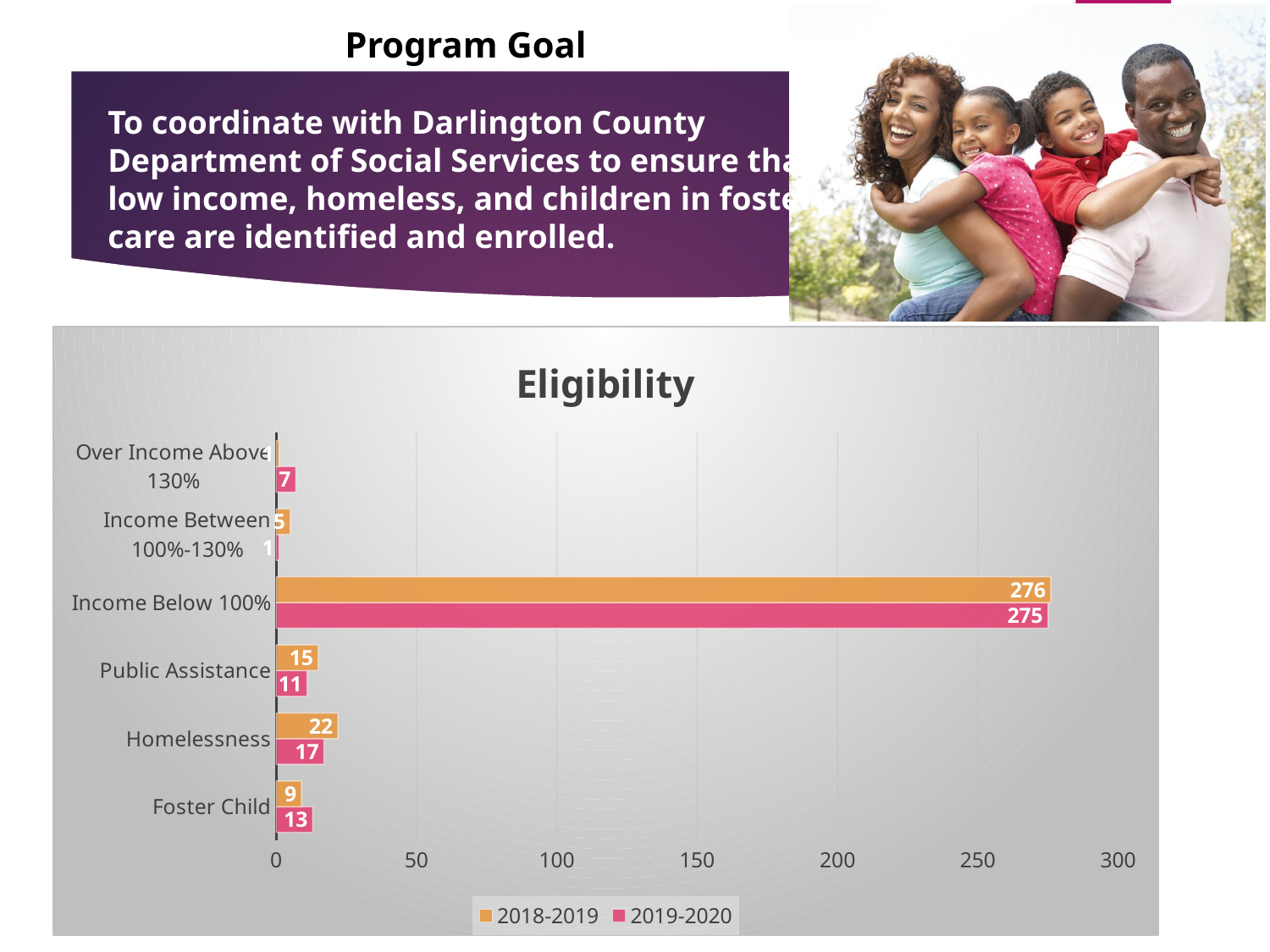
Which category has the lowest 2019-2020 value in the Eligibility chart? Income Between 100%-130% Which category has the highest 2019-2020 value in the Eligibility chart? Income Below 100% What is the 2019-2020 value for Homelessness in the Eligibility chart? 17 Is the 2018-2019 value for Income Below 100% in the Eligibility chart greater or less than 250? greater How many series does the legend of the Eligibility chart list? 2 Which series in the Eligibility chart is shown in orange? 2018-2019 What is the 2019-2020 value for Foster Child in the Eligibility chart? 13 What is the difference between the 2018-2019 and 2019-2020 values for Homelessness in the Eligibility chart? 5 What is the 2018-2019 value for Income Below 100% in the Eligibility chart? 276 What type of chart is shown under the title "Eligibility"? Bar chart How many categories are shown on the Eligibility chart? 6 For Foster Child in the Eligibility chart, which series has the larger value, 2018-2019 or 2019-2020? 2019-2020